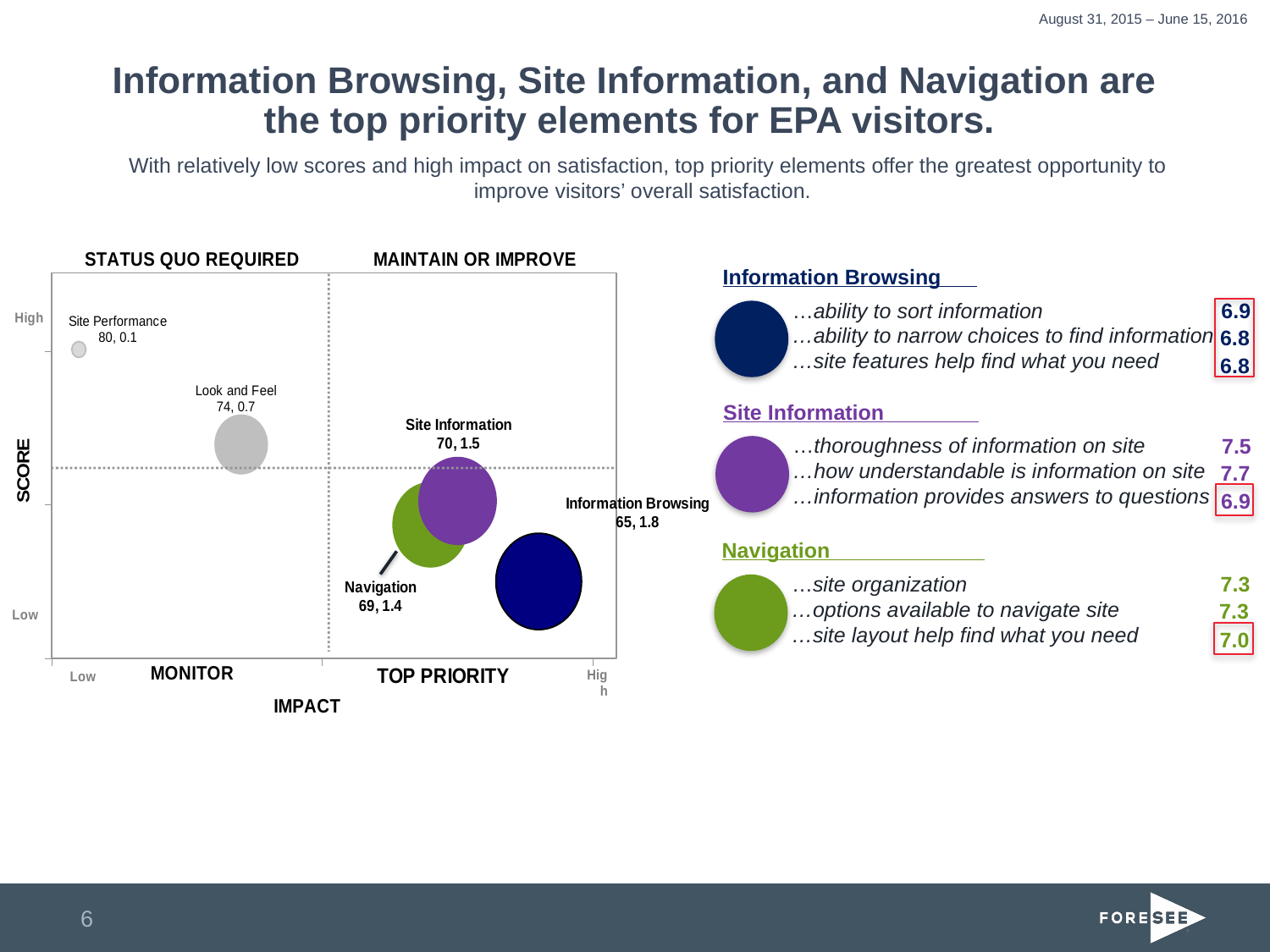
What kind of chart is shown on the slide? Bubble chart What is the label of the horizontal axis of the chart? IMPACT Which element has the highest score on the chart? Site Performance Which element has the lowest impact on the chart? Site Performance Which element has the lowest score on the chart? Information Browsing Which has the larger impact value, Look and Feel or Navigation? Navigation What is the difference in score between Site Performance and Information Browsing? 15 What is the impact value for Information Browsing on the chart? 1.8 What are the score and impact values for Look and Feel? 74, 0.7 What is the difference in impact between Site Information and Navigation? 0.1 What is the score for Site Information on the chart? 70 How many elements are plotted on the chart? 5